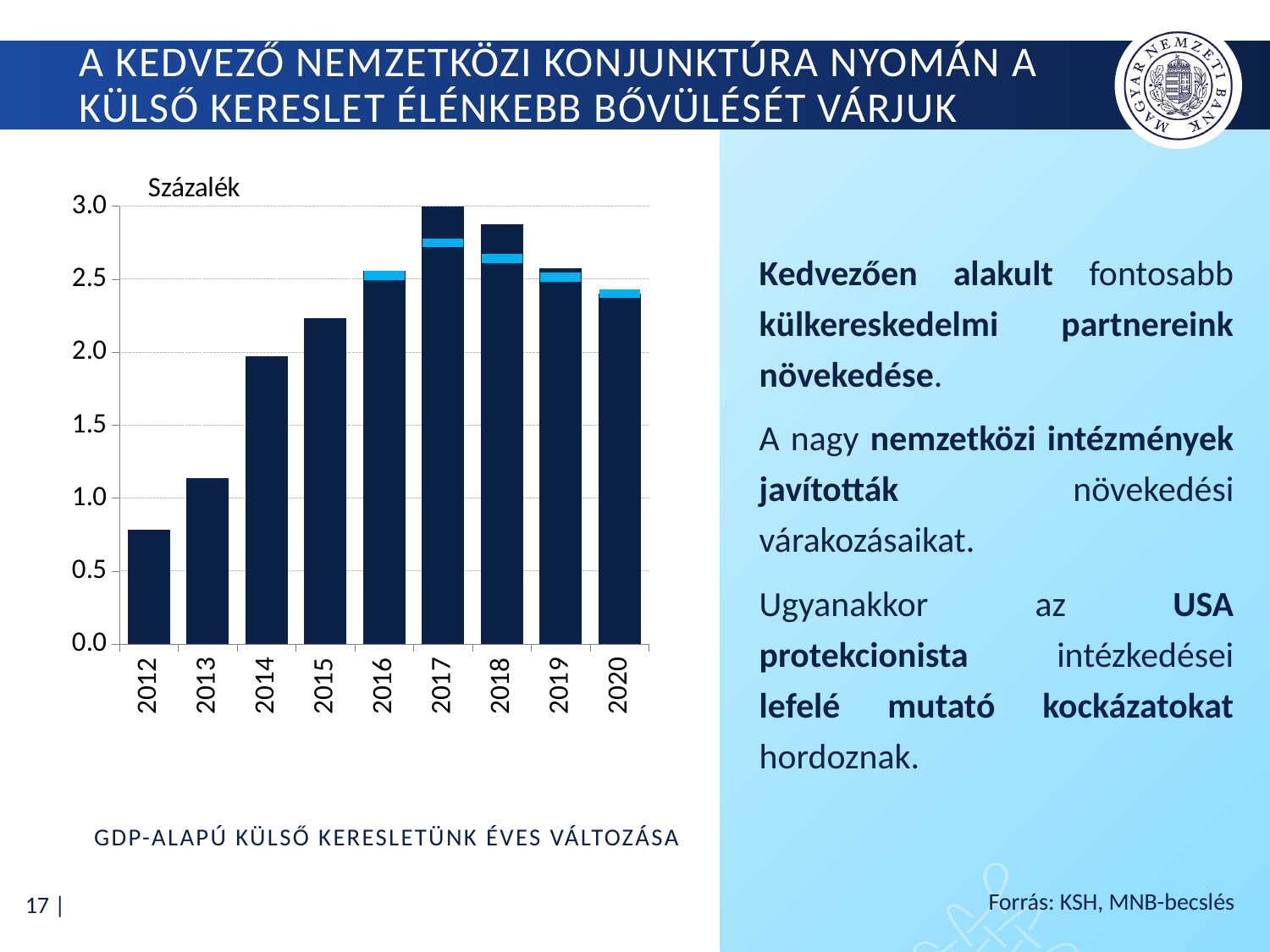
Is the value for 2015 greater or less than 2.0? greater Is the value for 2012 greater or less than 1.0? less What kind of chart is shown on the slide? bar chart What unit is shown at the top of the vertical axis of the chart? Százalék Is the value for 2014 greater or less than 1.5? greater Which is larger, the value for 2013 or the value for 2019? 2019 Which year has the highest bar in the chart? 2017 Do the values rise or fall from 2012 to 2017? rise How many years are shown on the x axis of the chart? 9 Which year has the lowest bar in the chart? 2012